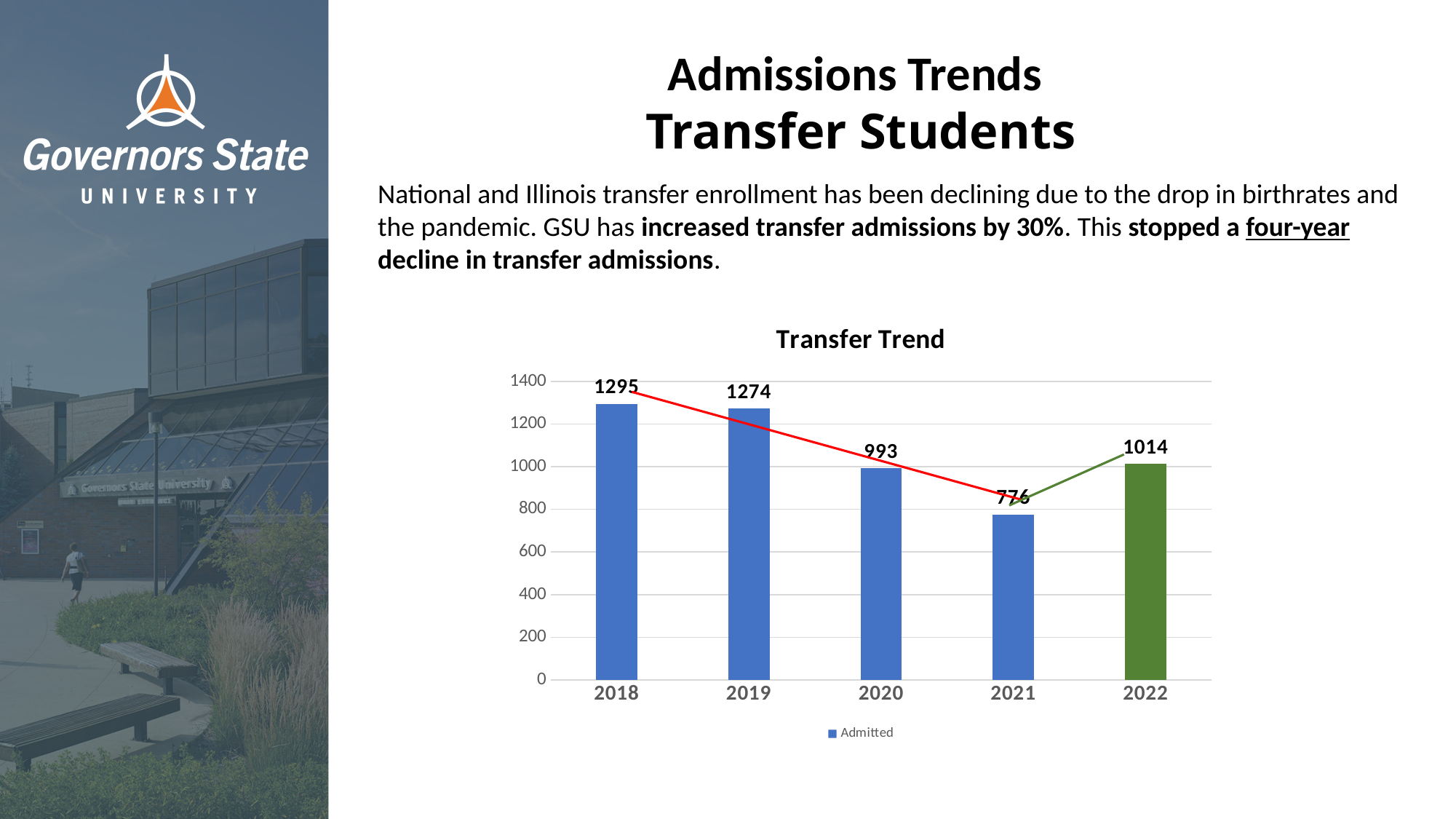
What is the difference between the 2022 and 2021 values in the Transfer Trend chart? 238 Which year has the highest value in the Transfer Trend chart? 2018 Which is larger in the Transfer Trend chart, the value for 2020 or the value for 2022? 2022 What is the difference between the 2018 and 2019 values in the Transfer Trend chart? 21 What is the value for 2018 in the Transfer Trend chart? 1295 Is the value for 2020 in the Transfer Trend chart greater or less than 1200? less What is the value for 2022 in the Transfer Trend chart? 1014 Which year has the lowest value in the Transfer Trend chart? 2021 How many years are shown in the Transfer Trend chart? 5 What series name does the legend of the Transfer Trend chart show? Admitted What kind of chart is the Transfer Trend chart? bar chart What is the value for 2021 in the Transfer Trend chart? 776